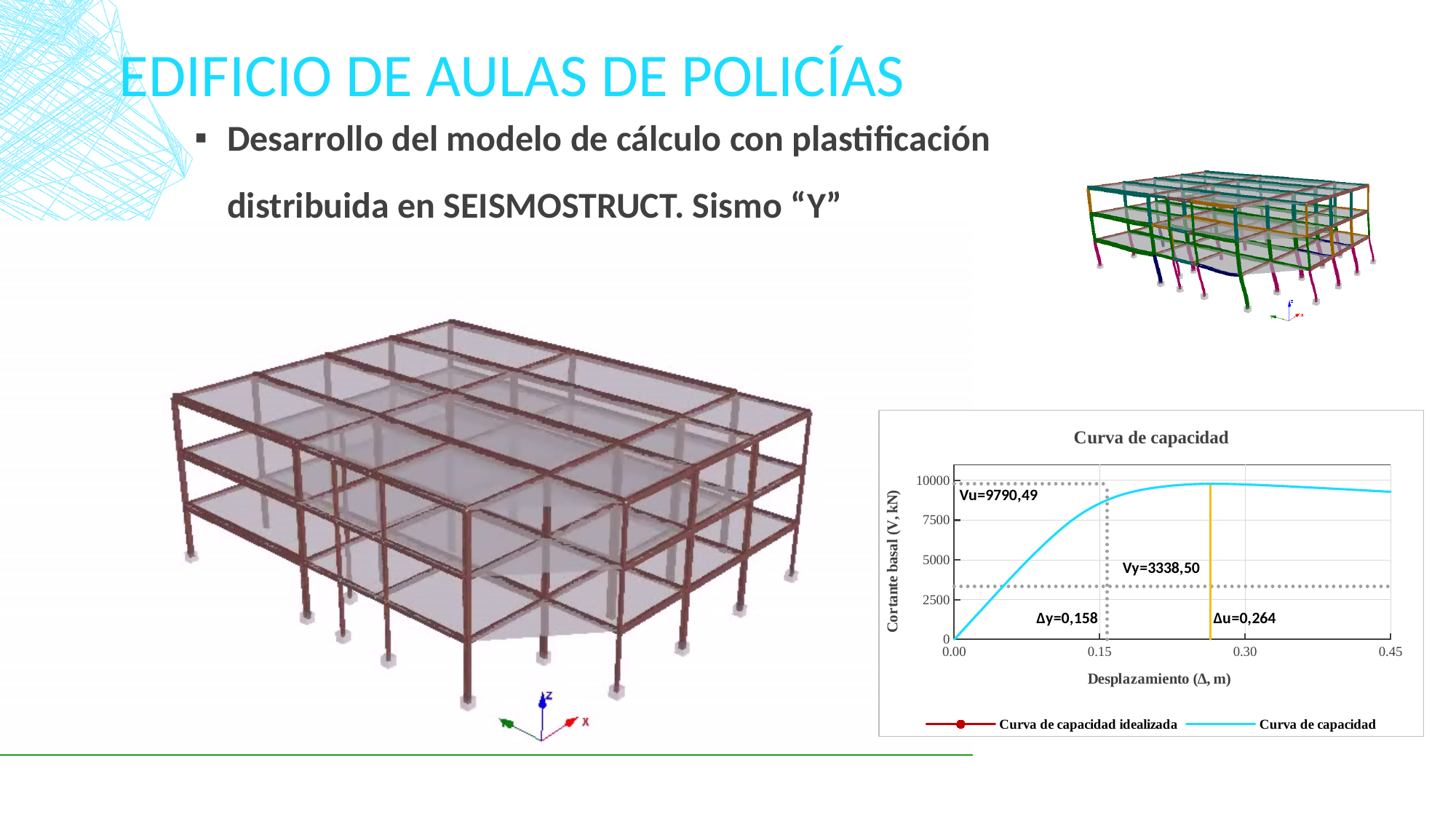
In the 'Curva de capacidad' chart, what is the value of Δu? 0,264 What kind of chart is the 'Curva de capacidad' chart? line chart What is the label of the x axis of the 'Curva de capacidad' chart? Desplazamiento (Δ, m) In the 'Curva de capacidad' chart, what is the value of Vu? 9790,49 In the 'Curva de capacidad' chart, what is the value of Vy? 3338,50 How many series does the legend of the 'Curva de capacidad' chart list? 2 In the 'Curva de capacidad' chart, what is the difference between Δu and Δy? 0,106 In the 'Curva de capacidad' chart, which is larger, Vu or Vy? Vu What is the title of the chart on the slide? Curva de capacidad In the 'Curva de capacidad' chart, what is the difference between Vu and Vy? 6451,99 In the 'Curva de capacidad' chart, what is the value of Δy? 0,158 In the 'Curva de capacidad' chart, is the base shear at a displacement of 0.30 m greater or less than 7500? greater